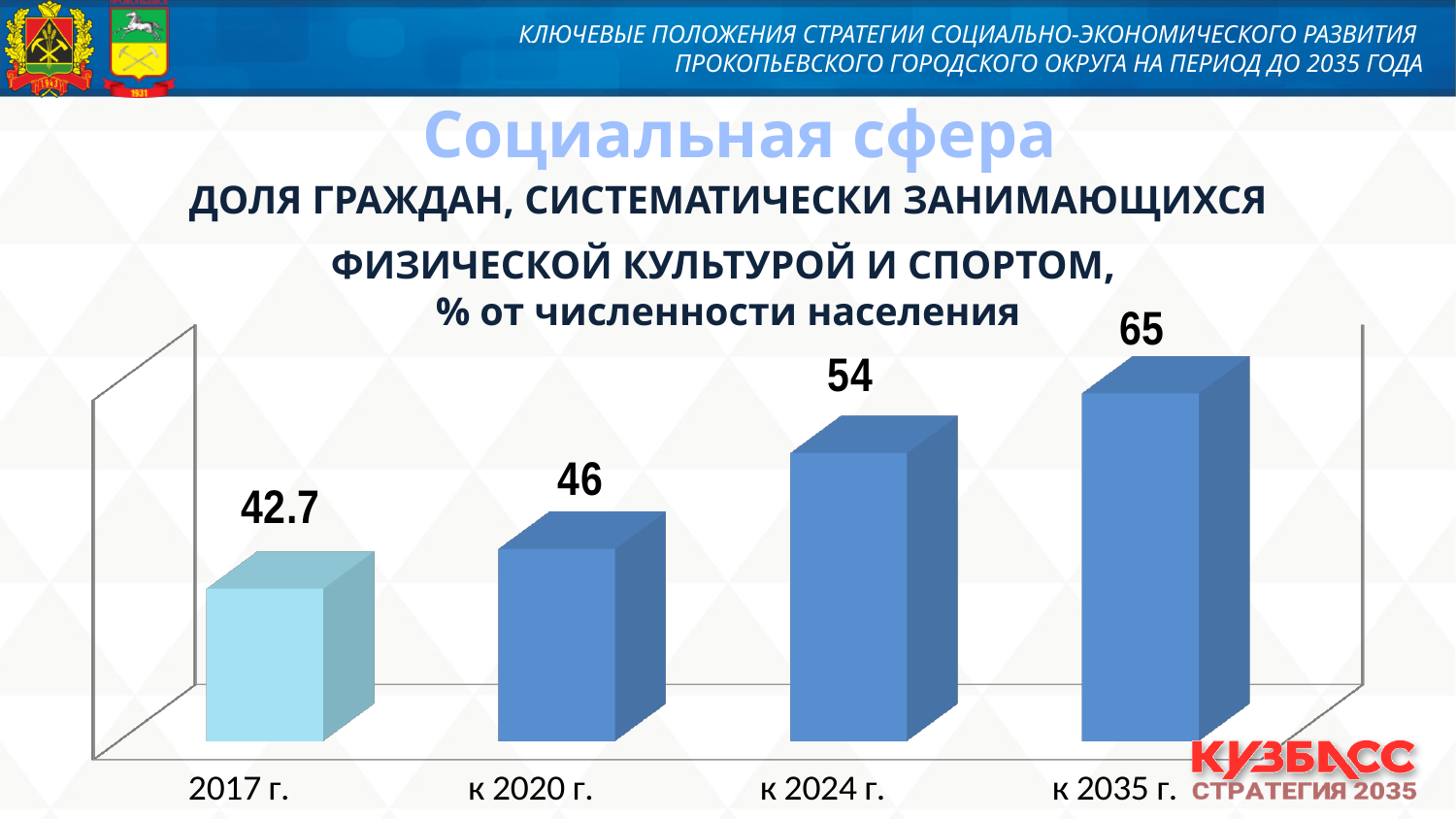
What is the difference between the values for к 2035 г. and 2017 г.? 22.3 Which category has the highest value? к 2035 г. What is the value for к 2024 г.? 54 Do the values rise or fall from 2017 г. to к 2035 г.? rise What kind of chart is this? bar chart How many categories are shown on the chart? 4 Which category has the lowest value? 2017 г. What is the value for 2017 г.? 42.7 What is the value for к 2035 г.? 65 Which is larger, the value for к 2020 г. or the value for к 2024 г.? к 2024 г. What is the value for к 2020 г.? 46 What is the difference between the values for к 2024 г. and к 2020 г.? 8